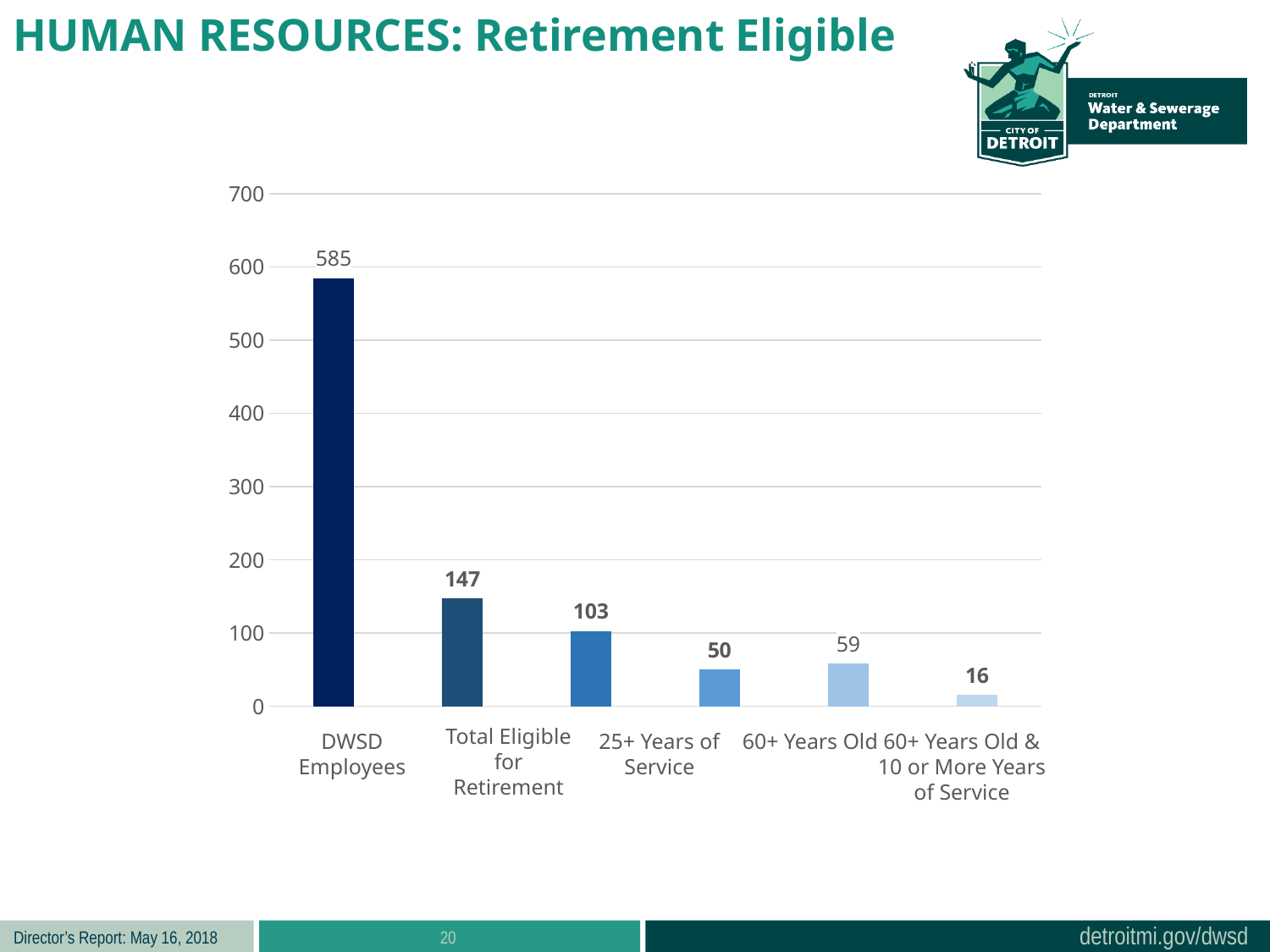
Which is larger, 25+ Years of Service or 60+ Years Old? 25+ Years of Service What is the value for 25+ Years of Service? 103 What kind of chart is shown on the slide? bar chart What is the difference between DWSD Employees and Total Eligible for Retirement? 438 What is the value for DWSD Employees? 585 What is the title of the slide containing the chart? HUMAN RESOURCES: Retirement Eligible Which category has the highest value? DWSD Employees What is the value for Total Eligible for Retirement? 147 How many bars are plotted in the chart? 6